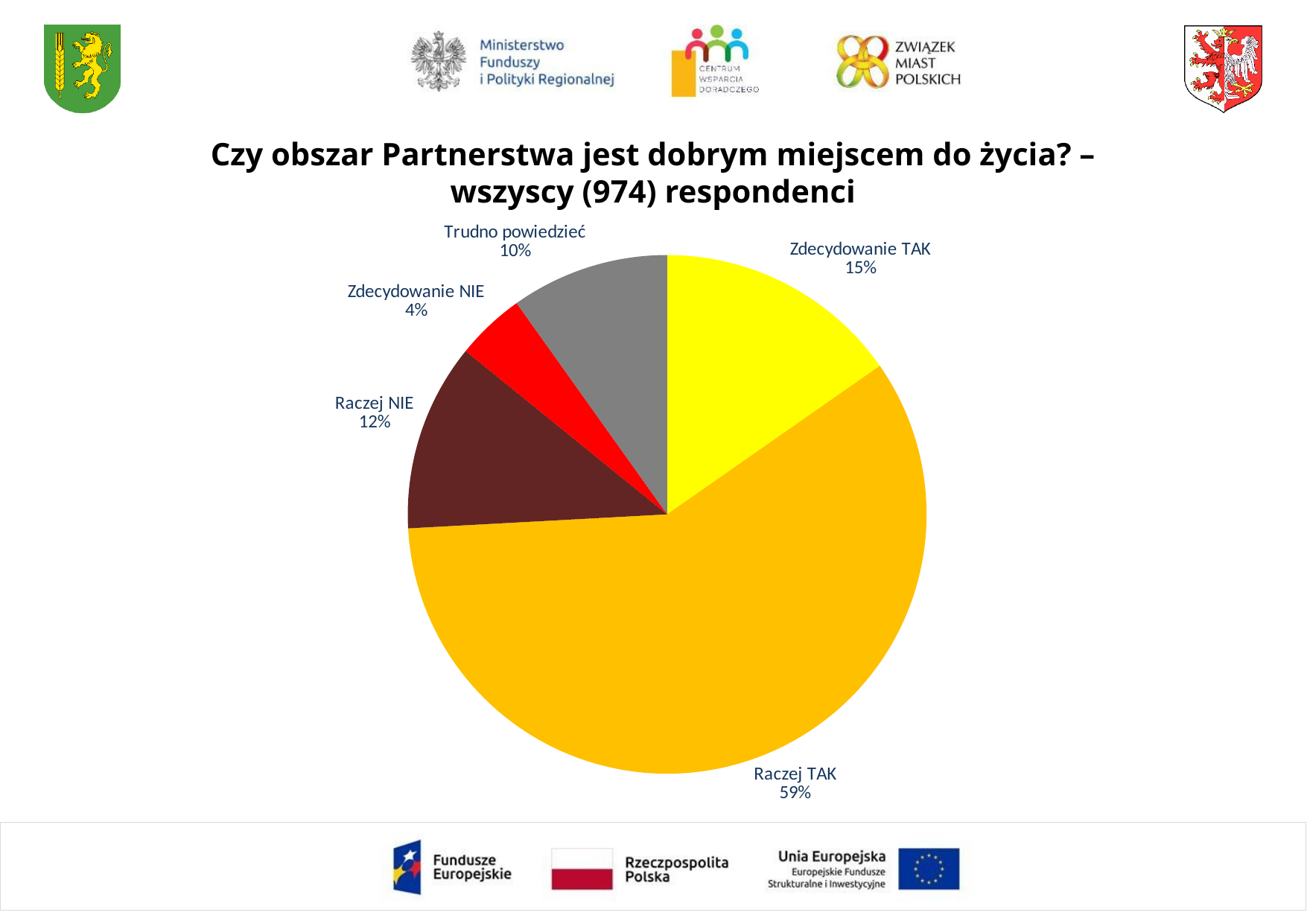
How many slices does the pie chart have? 5 What share of respondents answered "Zdecydowanie NIE"? 4% What is the difference in percentage points between "Raczej TAK" and "Zdecydowanie TAK"? 44 What share of respondents answered "Zdecydowanie TAK"? 15% Which answer has the smallest share of the pie? Zdecydowanie NIE Which is larger: the share for "Raczej NIE" or the share for "Trudno powiedzieć"? Raczej NIE What share of respondents answered "Trudno powiedzieć"? 10% What kind of chart is shown on the slide? pie chart How many respondents does the chart title say took part in the survey? 974 What share of respondents answered "Raczej TAK"? 59% What share of respondents answered "Raczej NIE"? 12% Which answer has the largest share of the pie? Raczej TAK